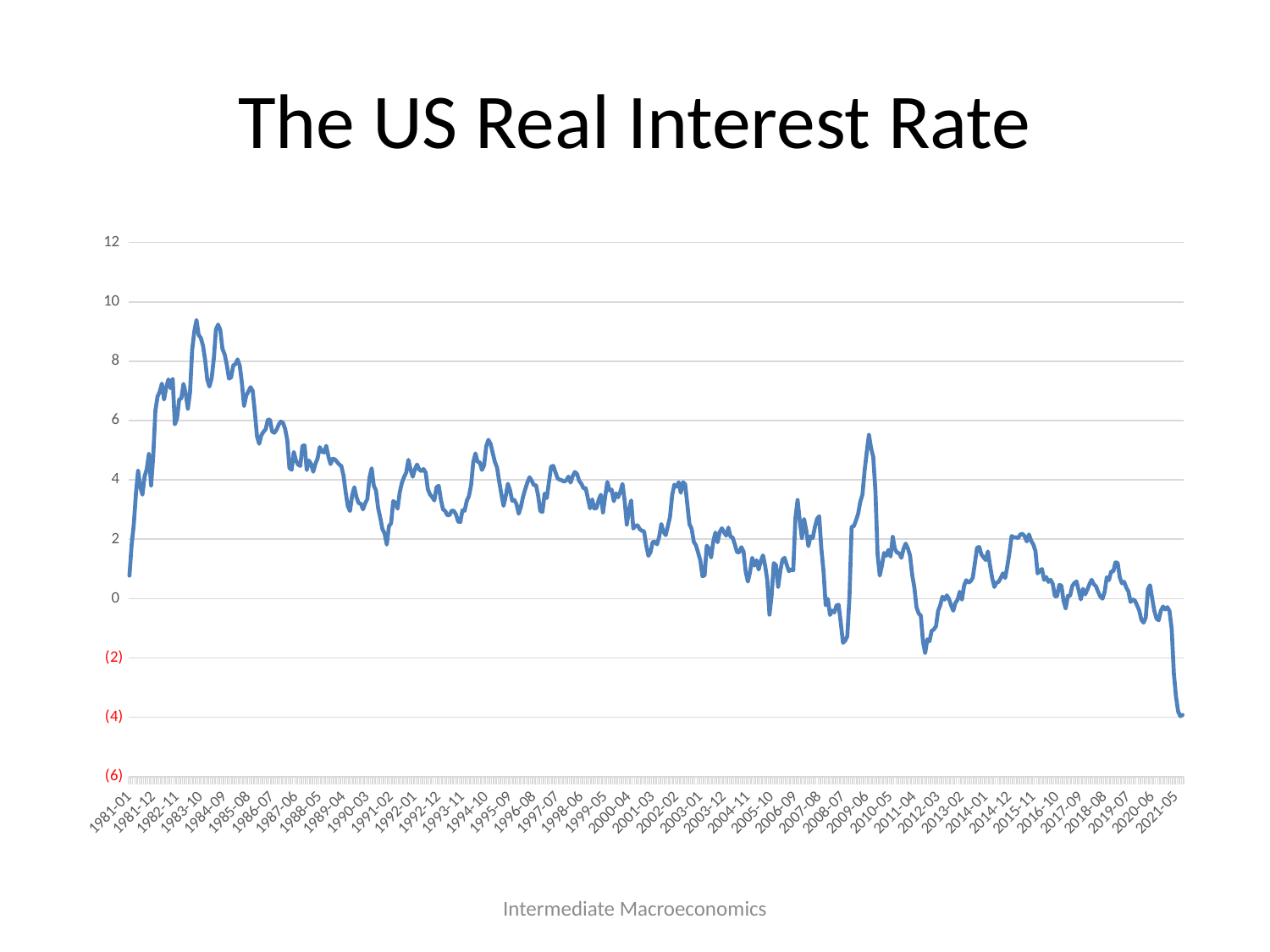
What is the highest value shown on the vertical axis? 12 Which is larger, the value at 1984-09 or the value at 1981-01? 1984-09 Which is larger, the value at 1990-03 or the value at 2021-05? 1990-03 What is the title of the chart? The US Real Interest Rate Is the value at 1981-01 greater or less than 2? less Is the value at 2009-06 greater or less than 4? greater Is the value at 2021-05 greater or less than (2)? less Over the whole period from 1981-01 to 2021-05, does the real interest rate generally rise or fall? fall What kind of chart is shown on the slide? line chart